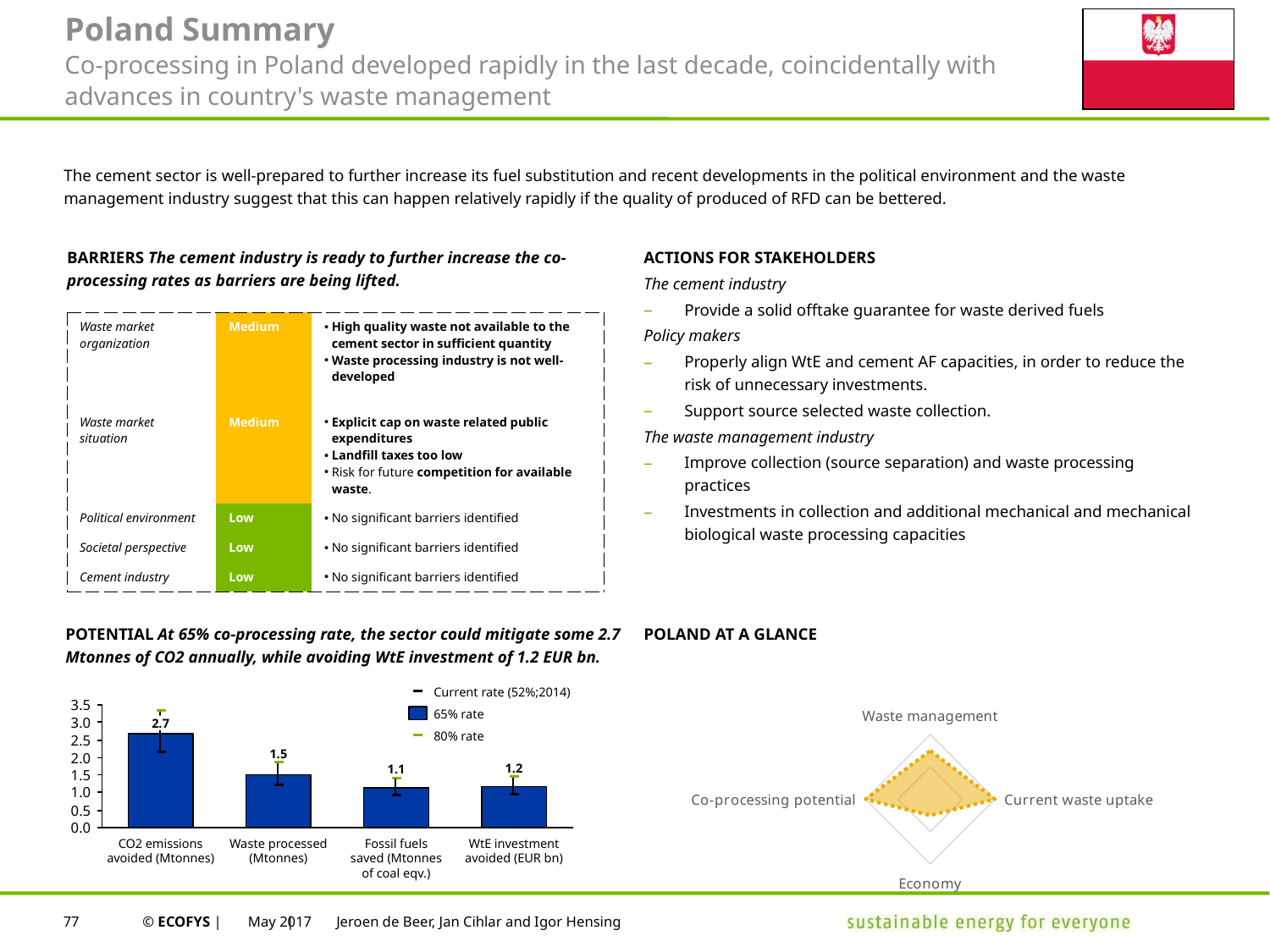
How many categories are shown on the x axis of the POTENTIAL bar chart? 4 In the POTENTIAL bar chart, what is the value for WtE investment avoided (EUR bn) at the 65% rate? 1.2 In the POTENTIAL bar chart, what is the value for Waste processed (Mtonnes) at the 65% rate? 1.5 In the POTENTIAL bar chart, which category has the lowest 65% rate bar? Fossil fuels saved (Mtonnes of coal eqv.) In the POTENTIAL bar chart, which category has the highest 65% rate bar? CO2 emissions avoided (Mtonnes) How many entries does the legend of the POTENTIAL chart list? 3 In the POTENTIAL bar chart, which is larger at the 65% rate: Waste processed or WtE investment avoided? Waste processed In the POTENTIAL bar chart, what is the value for CO2 emissions avoided (Mtonnes) at the 65% rate? 2.7 In the POTENTIAL bar chart, what is the difference between the 65% rate values for CO2 emissions avoided and Waste processed? 1.2 In the POTENTIAL bar chart, what is the value for Fossil fuels saved (Mtonnes of coal eqv.) at the 65% rate? 1.1 What kind of chart is shown under POLAND AT A GLANCE? Radar chart In the POTENTIAL bar chart, is the 80% rate marker for CO2 emissions avoided greater or less than 3.0? greater